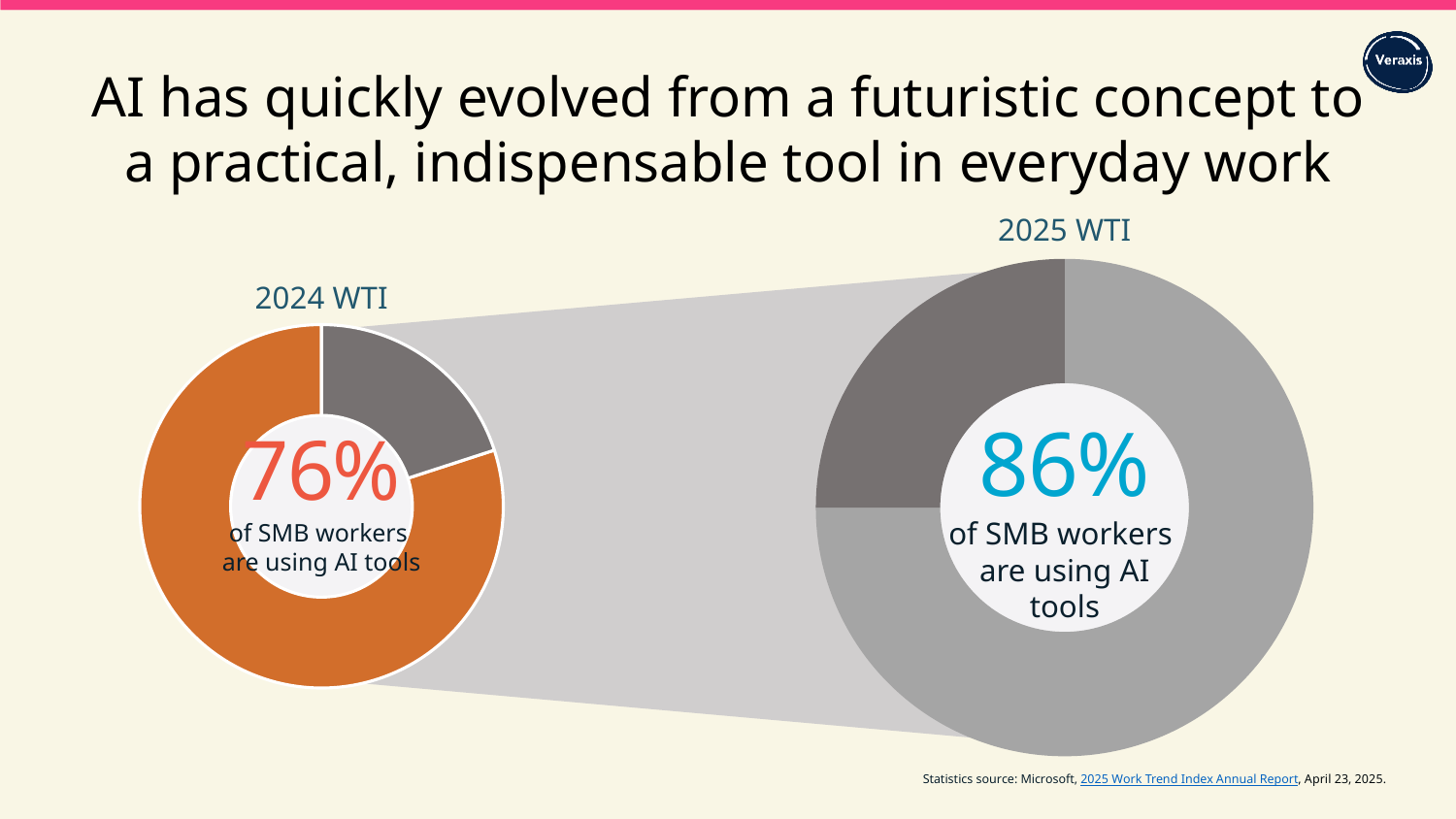
Does the share of SMB workers using AI tools rise or fall from 2024 WTI to 2025 WTI? Rise What colour is the large slice in the 2024 WTI donut chart? Orange In the 2024 WTI chart, is the share of SMB workers using AI tools greater or less than 50%? greater Which chart shows the higher share of SMB workers using AI tools, 2024 WTI or 2025 WTI? 2025 WTI By how many percentage points did the share of SMB workers using AI tools increase from the 2024 WTI chart to the 2025 WTI chart? 10 percentage points In the 2024 WTI chart, what percentage of SMB workers are using AI tools? 76% How many charts are shown on the slide? 2 What is the title of the chart on the right side of the slide? 2025 WTI In the 2025 WTI chart, what percentage of SMB workers are using AI tools? 86% In the 2025 WTI chart, is the share of SMB workers using AI tools greater or less than 80%? greater How many slices does the 2025 WTI donut chart have? 2 What kind of chart is used for the 2024 WTI figure? Donut (pie) chart